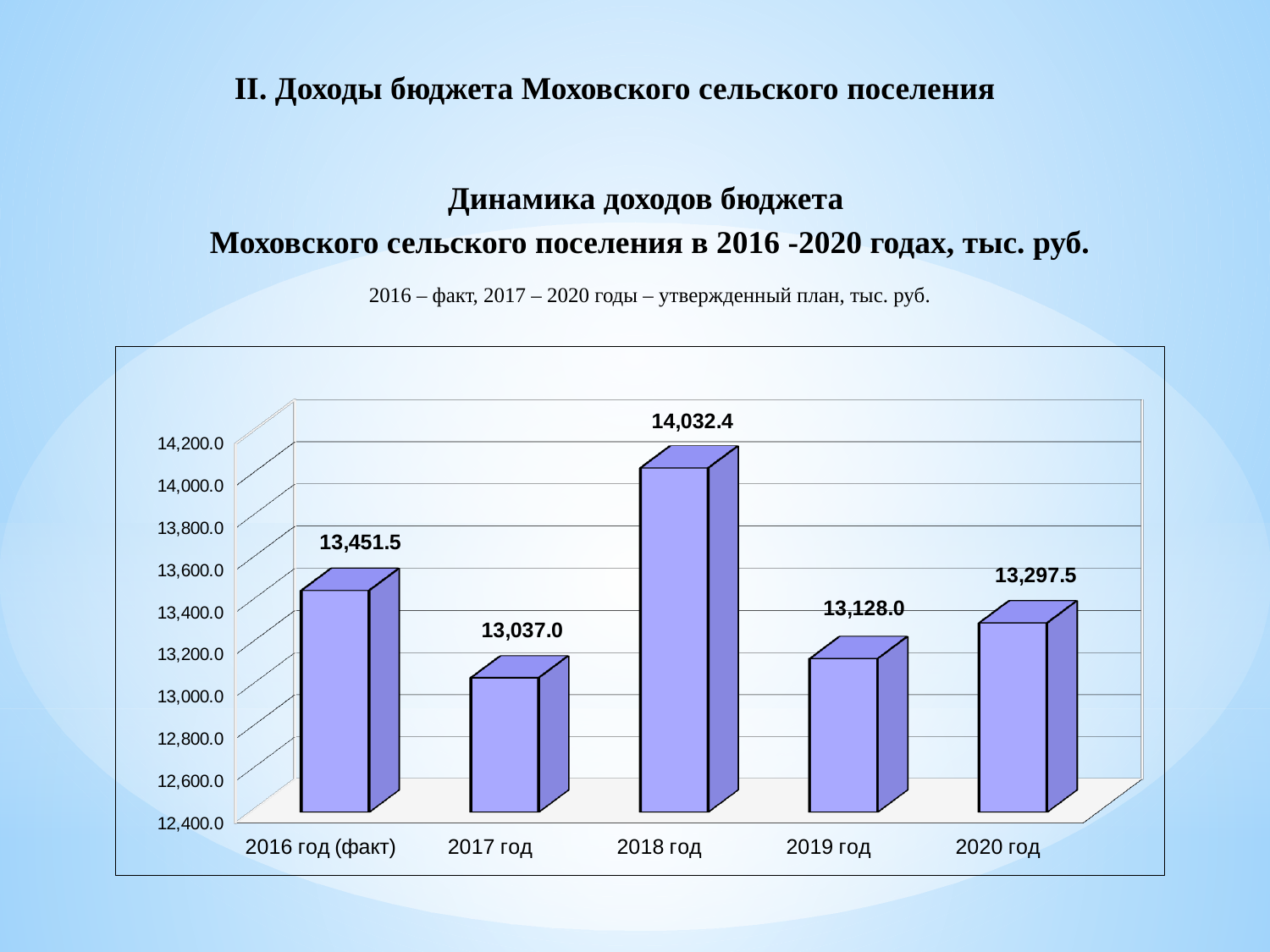
How many years are shown on the chart? 5 Which is larger, the value for 2019 год or the value for 2020 год? 2020 год What kind of chart is shown on the slide? bar chart Which year has the lowest value? 2017 год What is the difference between the values for 2016 год (факт) and 2020 год? 154.0 Is the value for 2017 год greater or less than 13,200.0? less What is the value for 2020 год? 13,297.5 What is the value for 2016 год (факт)? 13,451.5 What unit of measurement is stated in the chart title? тыс. руб. What is the value for 2018 год? 14,032.4 What is the difference between the values for 2018 год and 2017 год? 995.4 Which year has the highest value? 2018 год